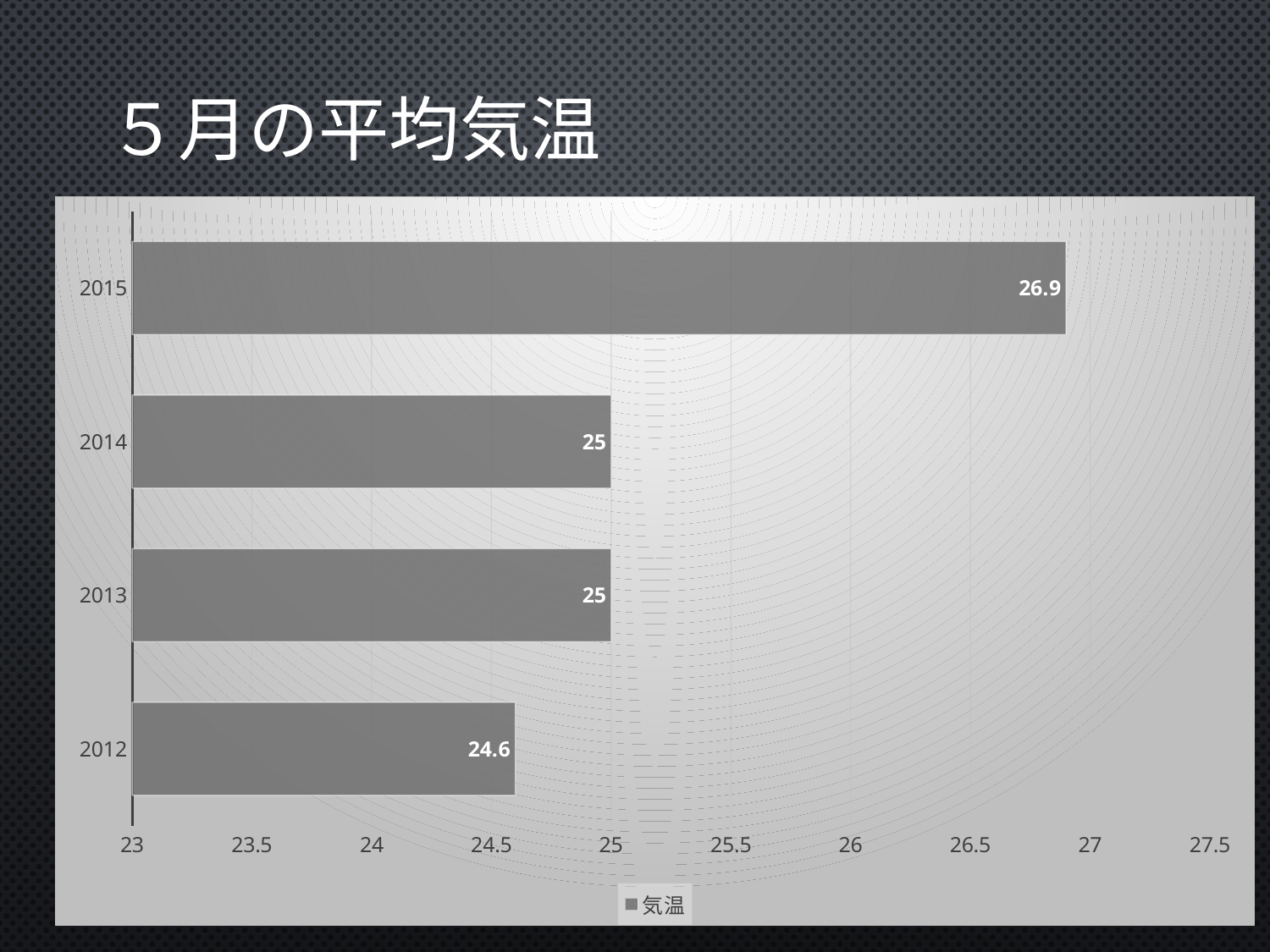
What kind of chart is shown on the slide? bar chart What is the difference between the values for 2014 and 2012? 0.4 How many years are shown in the chart? 4 What is the difference between the values for 2015 and 2012? 2.3 Which year has the lowest value? 2012 Which year has the highest value? 2015 What is the value for 2012? 24.6 Which is larger, the value for 2015 or the value for 2013? 2015 What is the value for 2014? 25 What series name does the legend show? 気温 What is the value for 2015? 26.9 Is the value for 2015 greater or less than 26? greater